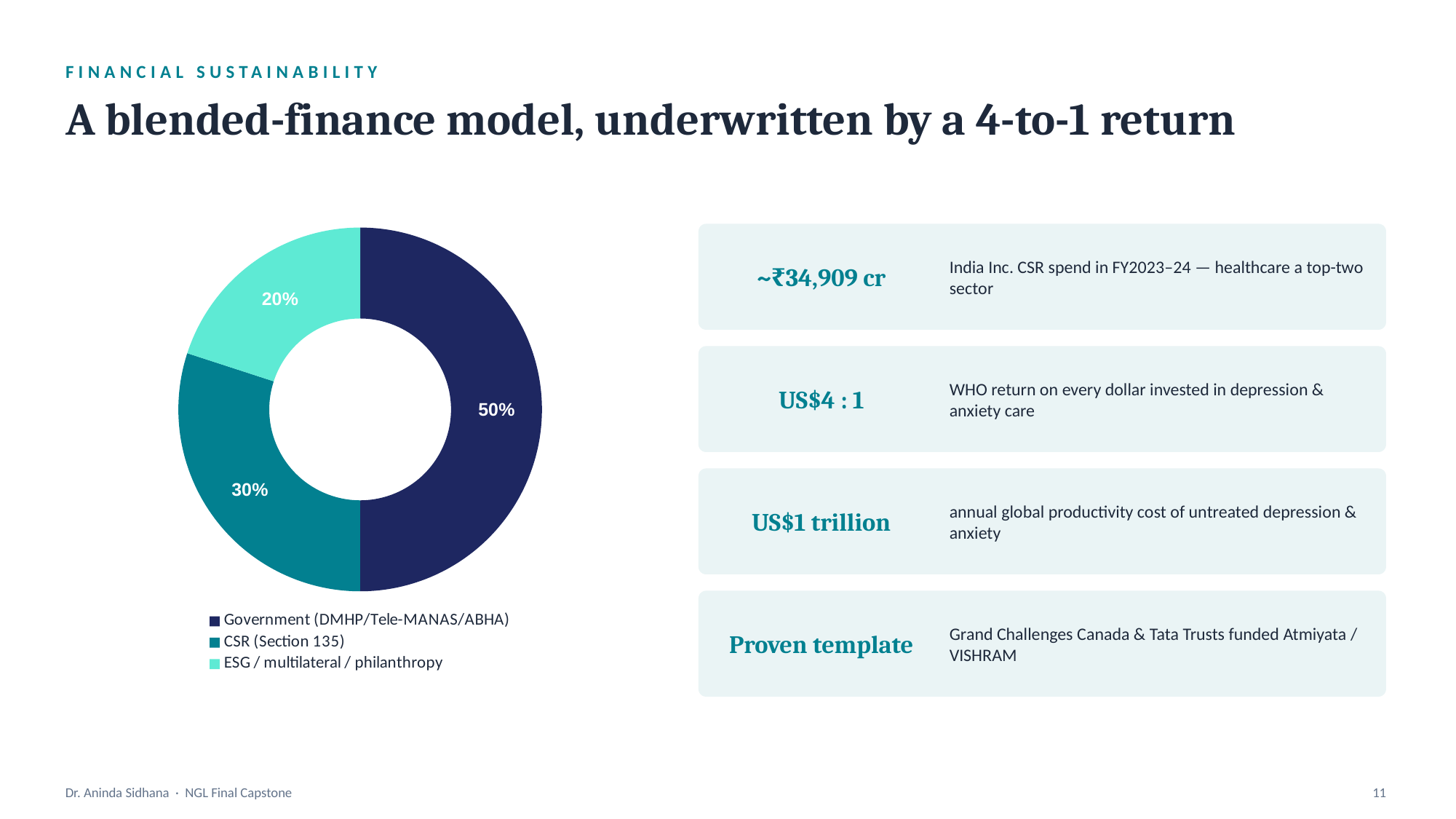
What share of the pie chart is ESG / multilateral / philanthropy? 20% Which category has the smallest slice in the pie chart? ESG / multilateral / philanthropy What kind of chart is shown on the slide? Pie chart (donut) Which is larger in the pie chart: CSR (Section 135) or ESG / multilateral / philanthropy? CSR (Section 135) What is the difference in percentage points between the CSR (Section 135) slice and the ESG / multilateral / philanthropy slice? 10 percentage points Which category has the largest slice in the pie chart? Government (DMHP/Tele-MANAS/ABHA) What share of the pie chart is Government (DMHP/Tele-MANAS/ABHA)? 50% What colour is the Government (DMHP/Tele-MANAS/ABHA) slice in the pie chart? Dark navy blue How many categories does the pie chart show? 3 What is the difference in percentage points between the Government slice and the CSR (Section 135) slice? 20 percentage points What is the combined share of the CSR (Section 135) and ESG / multilateral / philanthropy slices? 50% What share of the pie chart is CSR (Section 135)? 30%